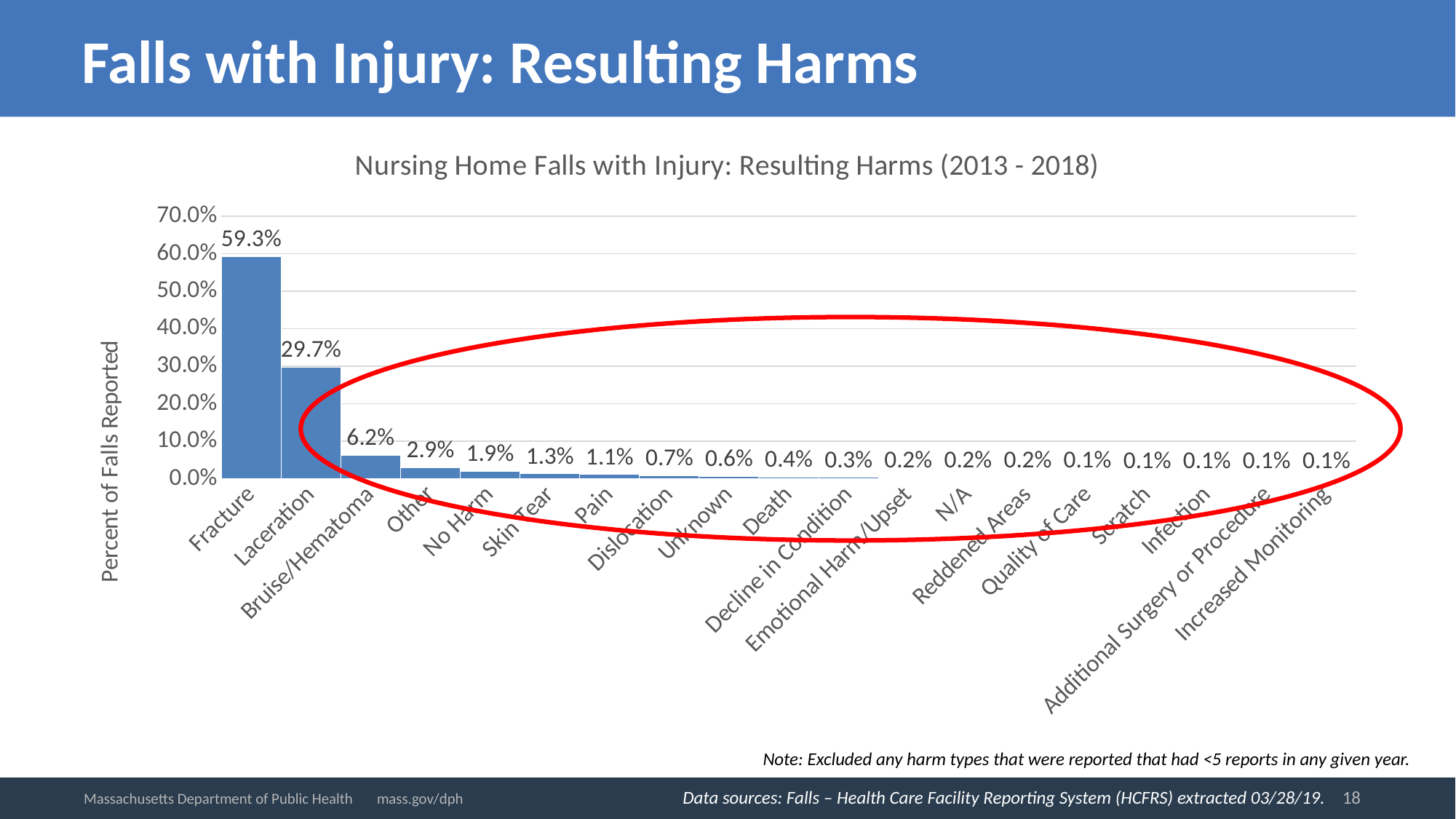
What is the value shown for Dislocation? 0.7% What kind of chart is shown on the slide? Bar chart Which is larger, the value for Skin Tear or the value for Pain? Skin Tear How many harm types are shown on the x axis? 19 Which harm type has the highest percent of falls reported? Fracture Is the value for Fracture greater or less than 50.0%? greater Do the values rise or fall moving from left to right along the x axis? Fall What is the difference between the values for Fracture and Laceration? 29.6% What is the value shown for Laceration? 29.7% What is the value shown for Death? 0.4% What percent of falls reported resulted in a Fracture? 59.3% What percent of falls reported resulted in Bruise/Hematoma? 6.2%